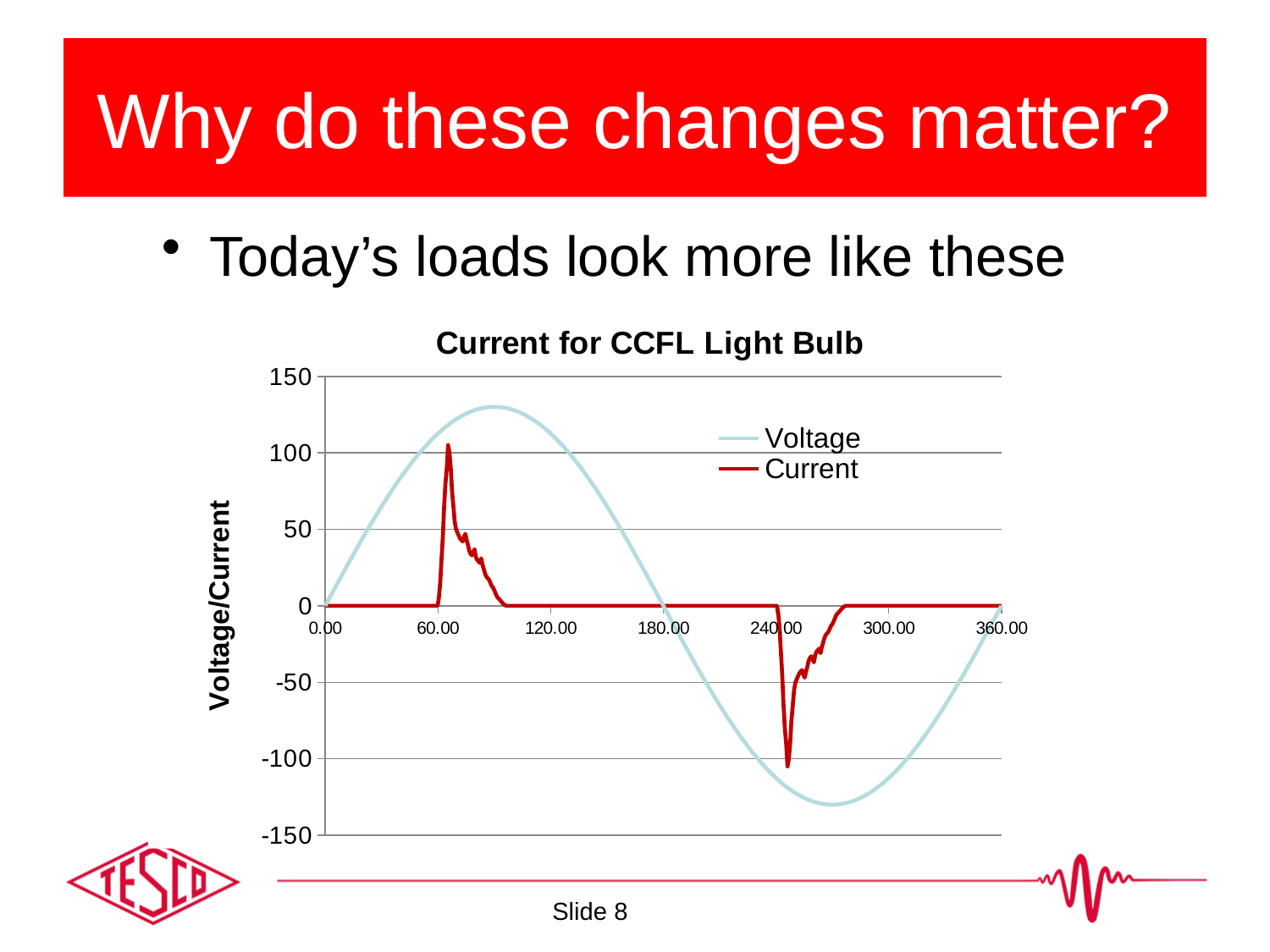
Is the lowest value of the Current series greater or less than -50? less What is the title of the chart? Current for CCFL Light Bulb What kind of chart is shown on the slide? line chart How many series does the legend list? 2 Which series reaches a higher peak value, Voltage or Current? Voltage Is the peak value of the Voltage series greater or less than 100? greater What is the label on the vertical axis of the chart? Voltage/Current Does the Voltage series rise or fall between 120.00 and 180.00 on the x axis? fall Is the peak value of the Voltage series greater or less than 150? less Does the Voltage series rise or fall between 0.00 and 60.00 on the x axis? rise